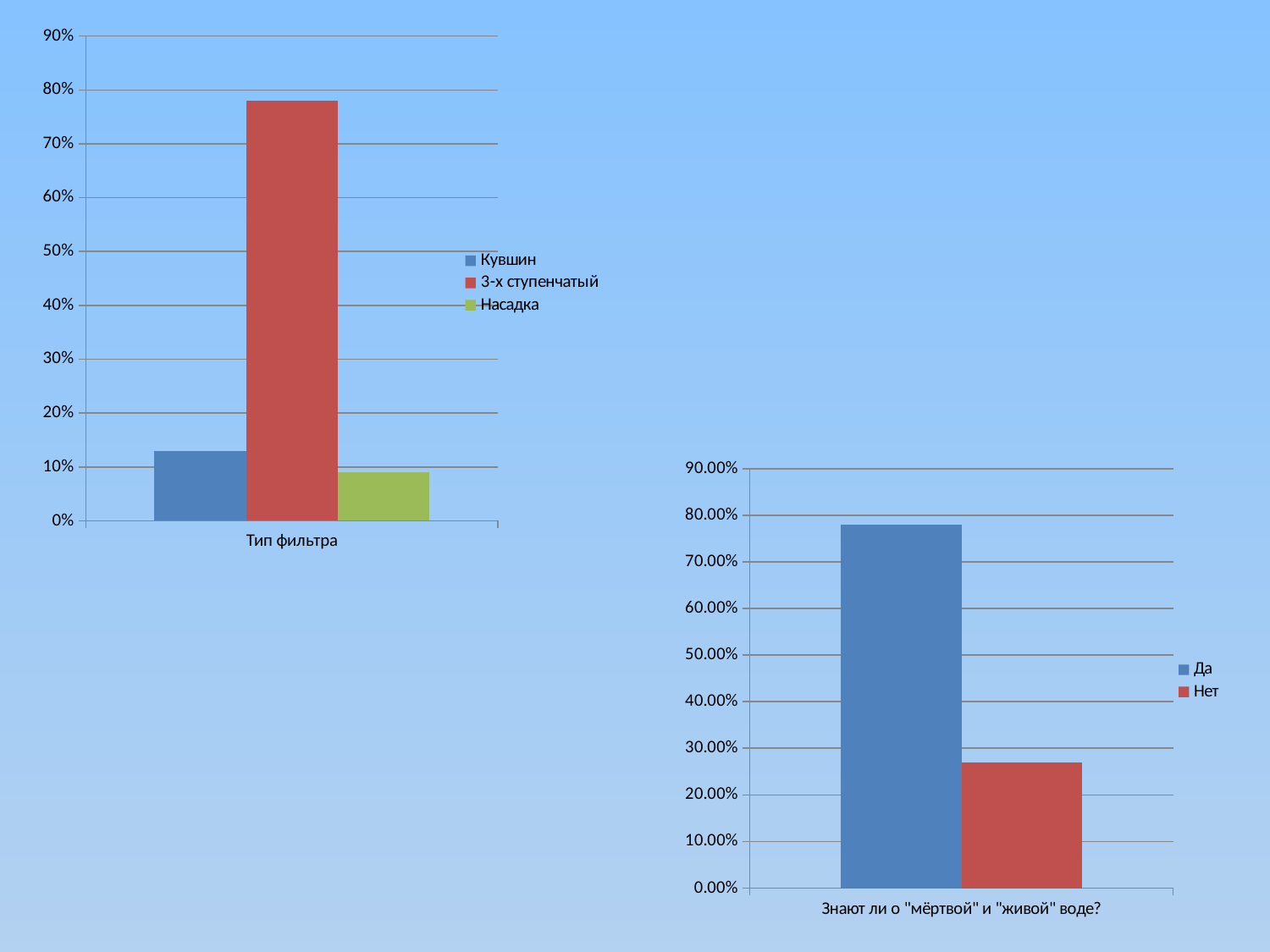
On the left chart (Тип фильтра), which series has the lowest value? Насадка On the left chart (Тип фильтра), which series has the highest value? 3-х ступенчатый On the right chart (Знают ли о "мёртвой" и "живой" воде?), is the value for Нет greater or less than 30.00%? less On the left chart (Тип фильтра), is the value for 3-х ступенчатый greater or less than 70%? greater What kind of chart is the left chart (Тип фильтра)? bar chart On the right chart (Знают ли о "мёртвой" и "живой" воде?), is the value for Да greater or less than 70.00%? greater On the left chart (Тип фильтра), which is larger, Кувшин or Насадка? Кувшин On the right chart (Знают ли о "мёртвой" и "живой" воде?), which series has the higher value? Да How many series does the legend of the right chart (Знают ли о "мёртвой" и "живой" воде?) list? 2 How many series does the legend of the left chart (Тип фильтра) list? 3